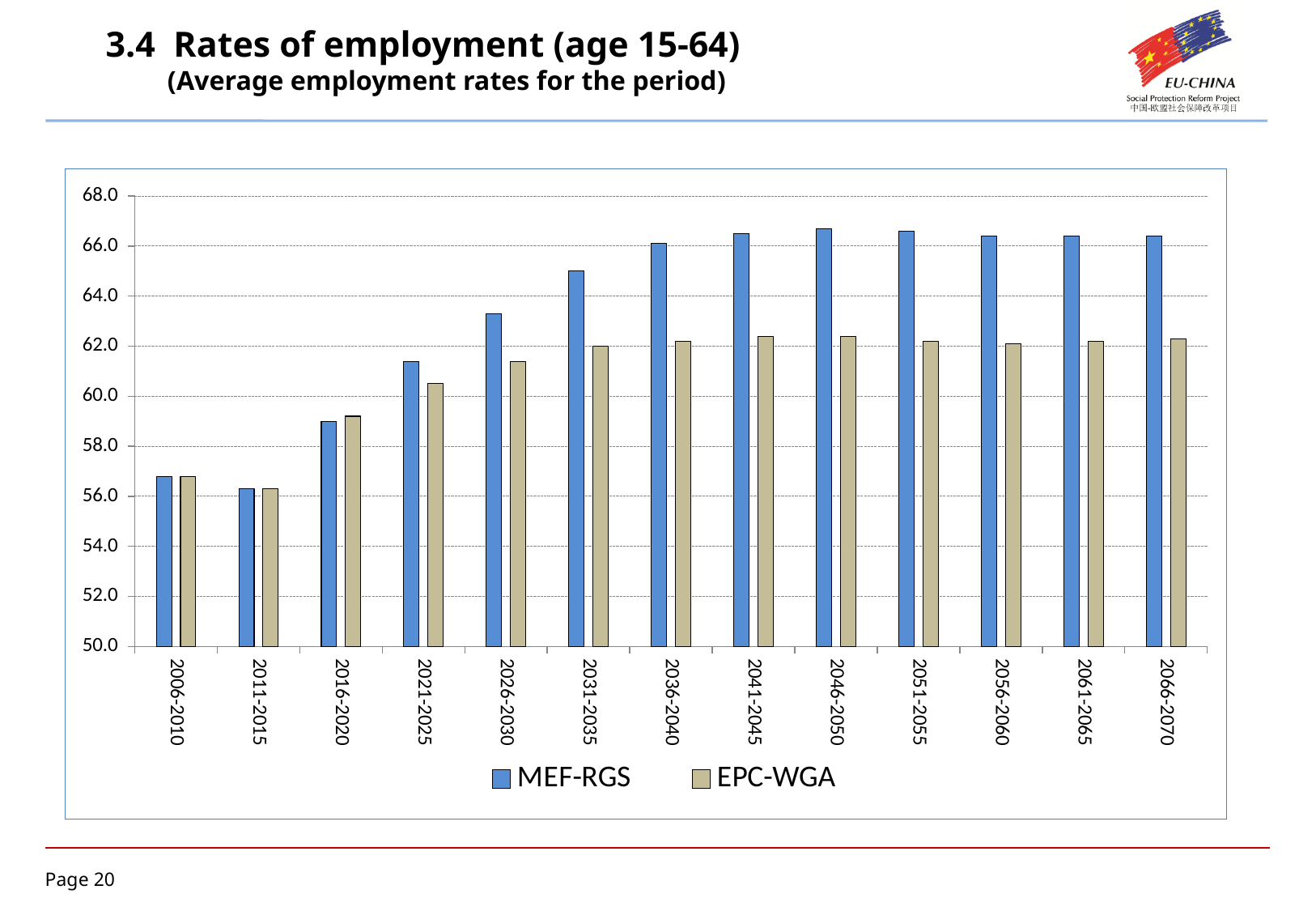
Is the MEF-RGS value for 2026-2030 greater or less than 62.0? greater What is the title of the chart on the slide? 3.4 Rates of employment (age 15-64) For 2036-2040, which series has the larger value, MEF-RGS or EPC-WGA? MEF-RGS Is the MEF-RGS value for 2046-2050 greater or less than 66.0? greater Is the EPC-WGA value for 2026-2030 greater or less than 60.0? greater Which period has the lowest MEF-RGS value? 2011-2015 Do the MEF-RGS values generally rise or fall from 2011-2015 to 2046-2050? rise Which series is shown in blue in the legend? MEF-RGS What kind of chart is shown on the slide? bar chart How many time periods are shown along the x axis? 13 How many series does the legend list? 2